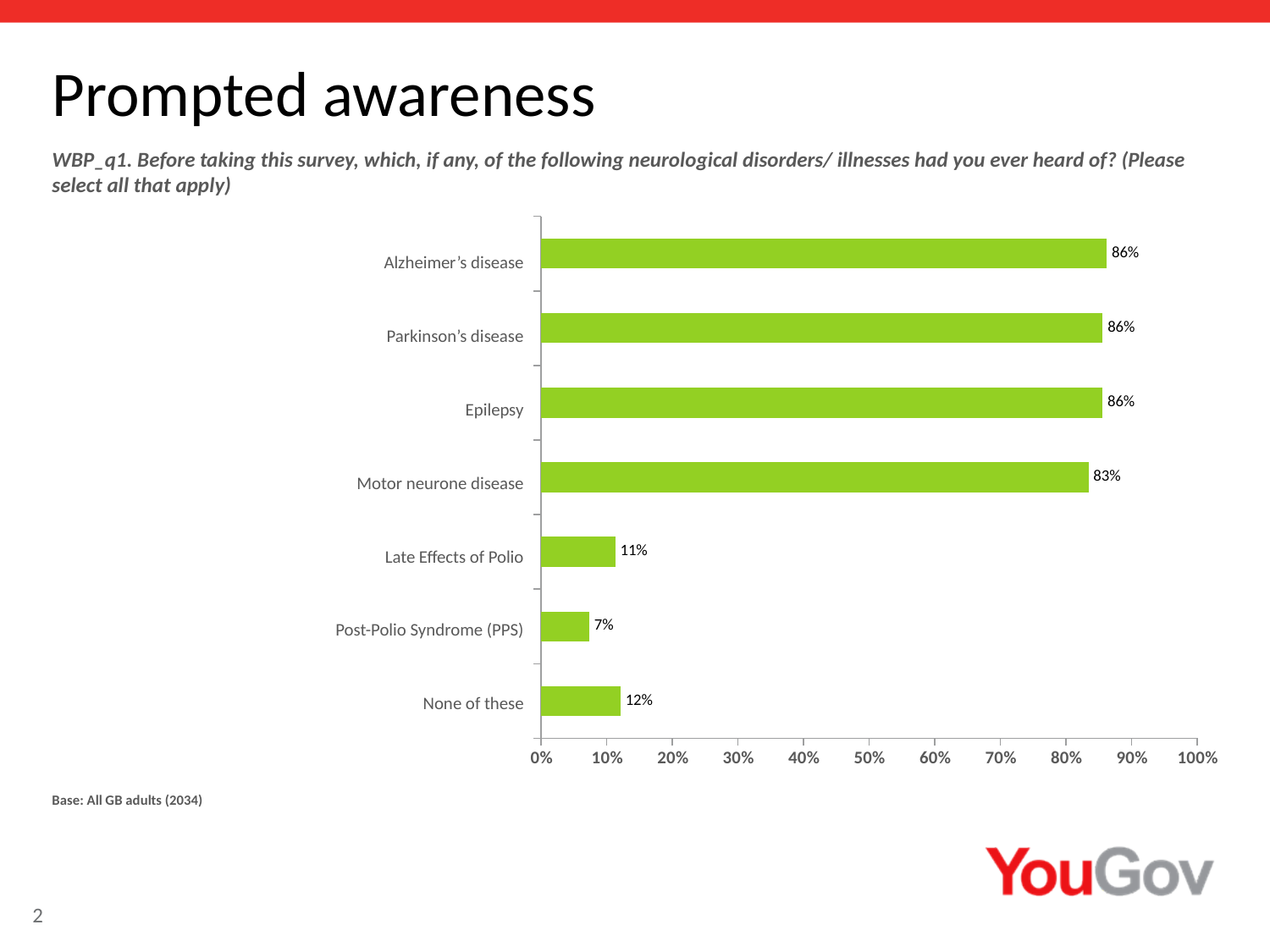
Is the value for Motor neurone disease greater or less than 80%? greater What is the value for Post-Polio Syndrome (PPS)? 7% What is the value for Late Effects of Polio? 11% How many categories are shown in the chart? 7 What is the base size stated below the chart? All GB adults (2034) What is the difference between the values for Late Effects of Polio and Post-Polio Syndrome (PPS)? 4% What percentage of respondents selected None of these? 12% What kind of chart is shown on the slide? Bar chart What percentage of respondents had heard of Motor neurone disease? 83% What is the difference between the values for Alzheimer's disease and Motor neurone disease? 3% Which category has the lowest value? Post-Polio Syndrome (PPS) Which is larger, the value for None of these or the value for Late Effects of Polio? None of these